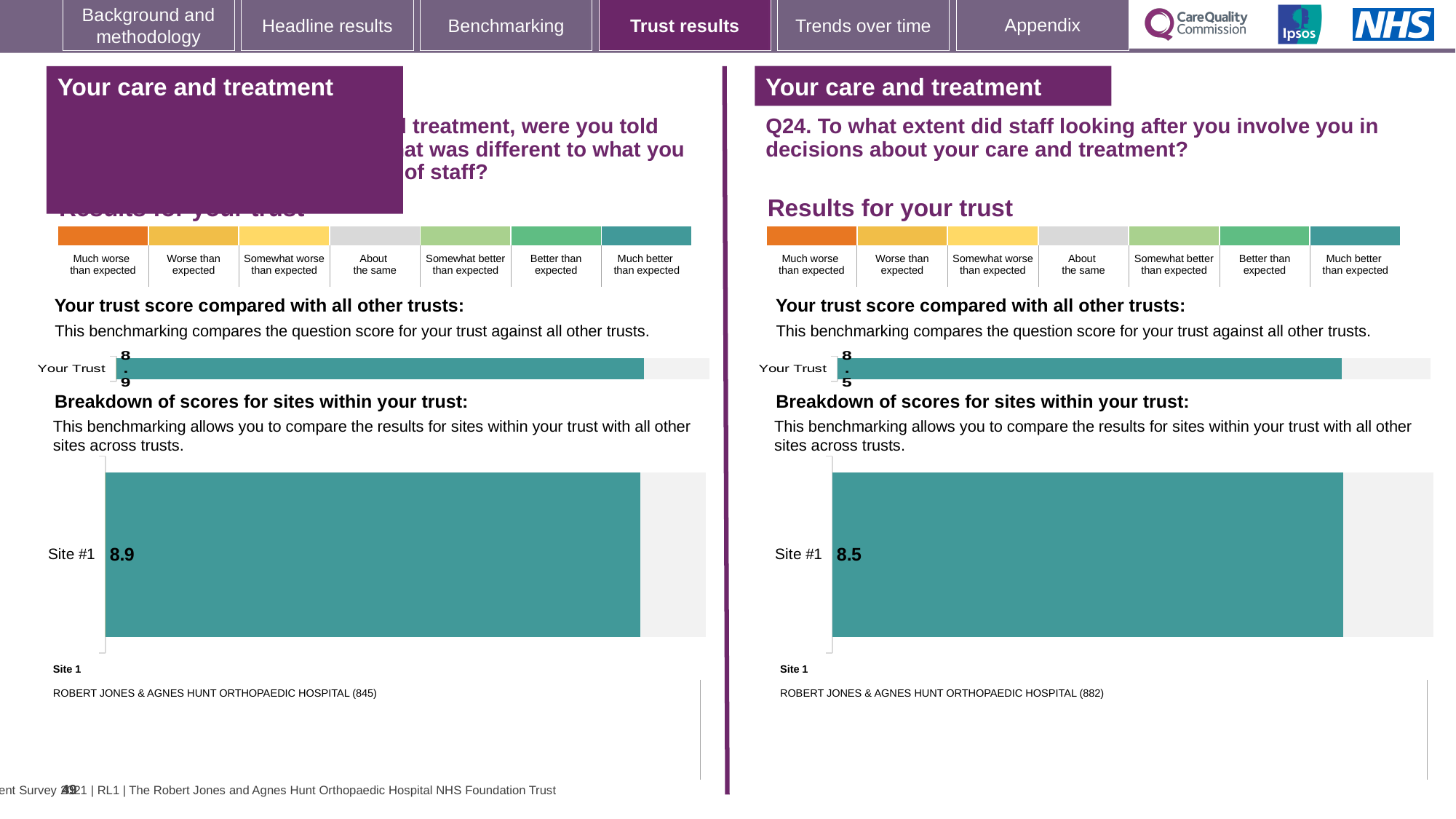
On the left half of the slide, what value is shown for 'Your Trust' in the 'Your trust score compared with all other trusts' chart? 8.9 What is the difference between the Site #1 score on the left half of the slide (8.9) and the Site #1 score on the right half (8.5)? 0.4 How many sites are shown in the 'Breakdown of scores for sites within your trust' chart on the right half of the slide (Q24)? 1 On the right half of the slide (Q24), what value is shown for 'Your Trust' in the 'Your trust score compared with all other trusts' chart? 8.5 Is the Site #1 score on the right half of the slide (Q24) greater or less than 8? greater On the left half of the slide, what is the name of Site 1 listed below the chart? ROBERT JONES & AGNES HUNT ORTHOPAEDIC HOSPITAL (845) Which is larger: the Site #1 score on the left half of the slide or the Site #1 score on the right half (Q24)? Left half (8.9) On the right half of the slide (Q24), what is the score shown for Site #1 in the 'Breakdown of scores for sites within your trust' chart? 8.5 On the left half of the slide, what is the score shown for Site #1 in the 'Breakdown of scores for sites within your trust' chart? 8.9 On the right half of the slide (Q24), what is the name of Site 1 listed below the chart? ROBERT JONES & AGNES HUNT ORTHOPAEDIC HOSPITAL (882) How many sites are shown in the 'Breakdown of scores for sites within your trust' chart on the left half of the slide? 1 What type of chart is used to show the Site #1 score on the right half of the slide (Q24)? Bar chart